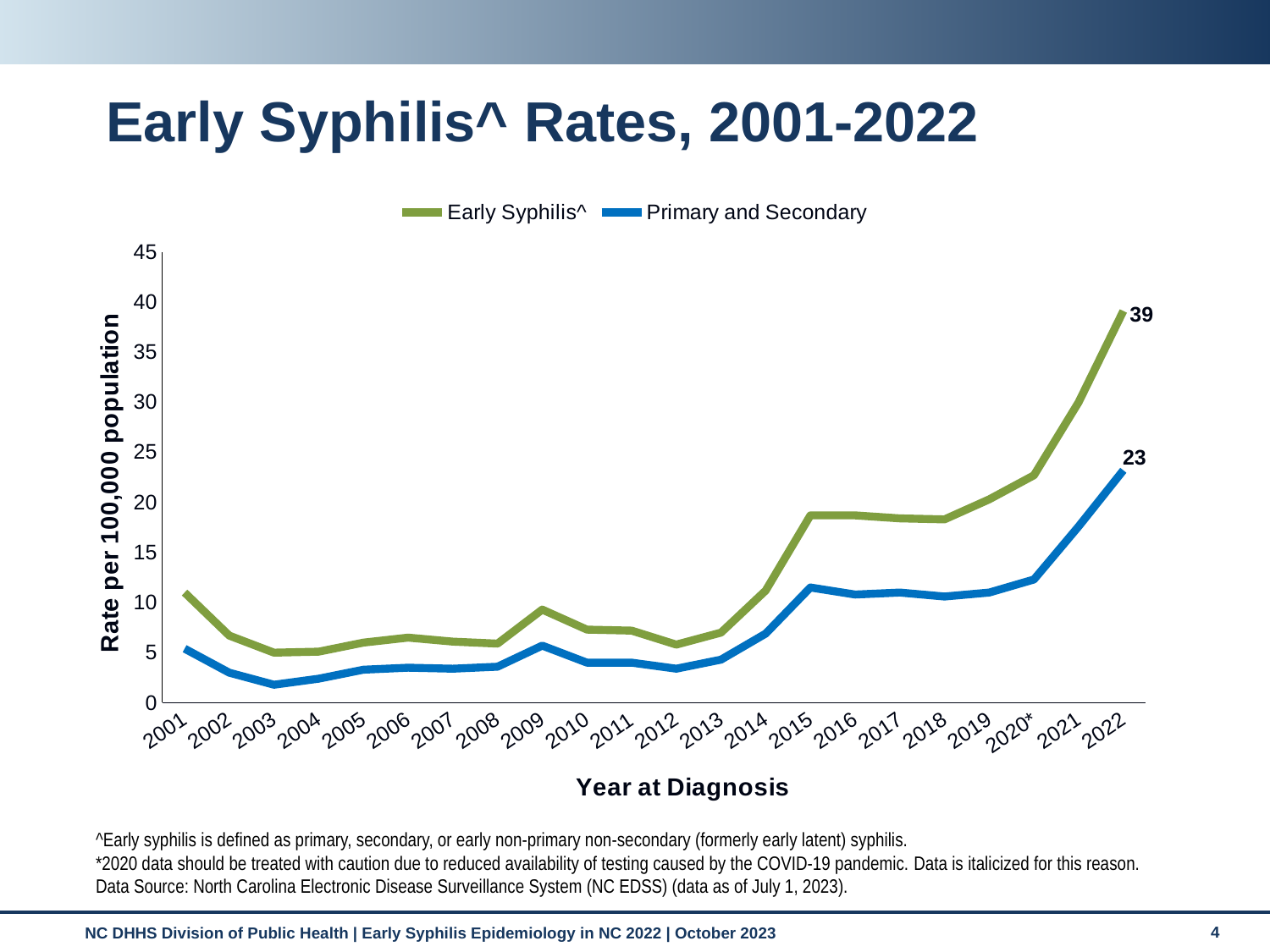
In which year is the Primary and Secondary rate lowest? 2003 Is the Primary and Secondary rate in 2001 greater or less than 10? less How many years are shown on the x axis of the chart? 22 How many series does the legend list? 2 Is the Early Syphilis^ rate in 2015 greater or less than 15? greater Is the Early Syphilis^ rate in 2020* greater or less than 20? greater In 2022, which series has the higher rate: Early Syphilis^ or Primary and Secondary? Early Syphilis^ What is the difference between the Early Syphilis^ rate and the Primary and Secondary rate in 2022? 16 What is the Early Syphilis^ rate per 100,000 population in 2022? 39 What is the Primary and Secondary rate per 100,000 population in 2022? 23 In which year is the Early Syphilis^ rate highest? 2022 What kind of chart is shown on the slide? line chart